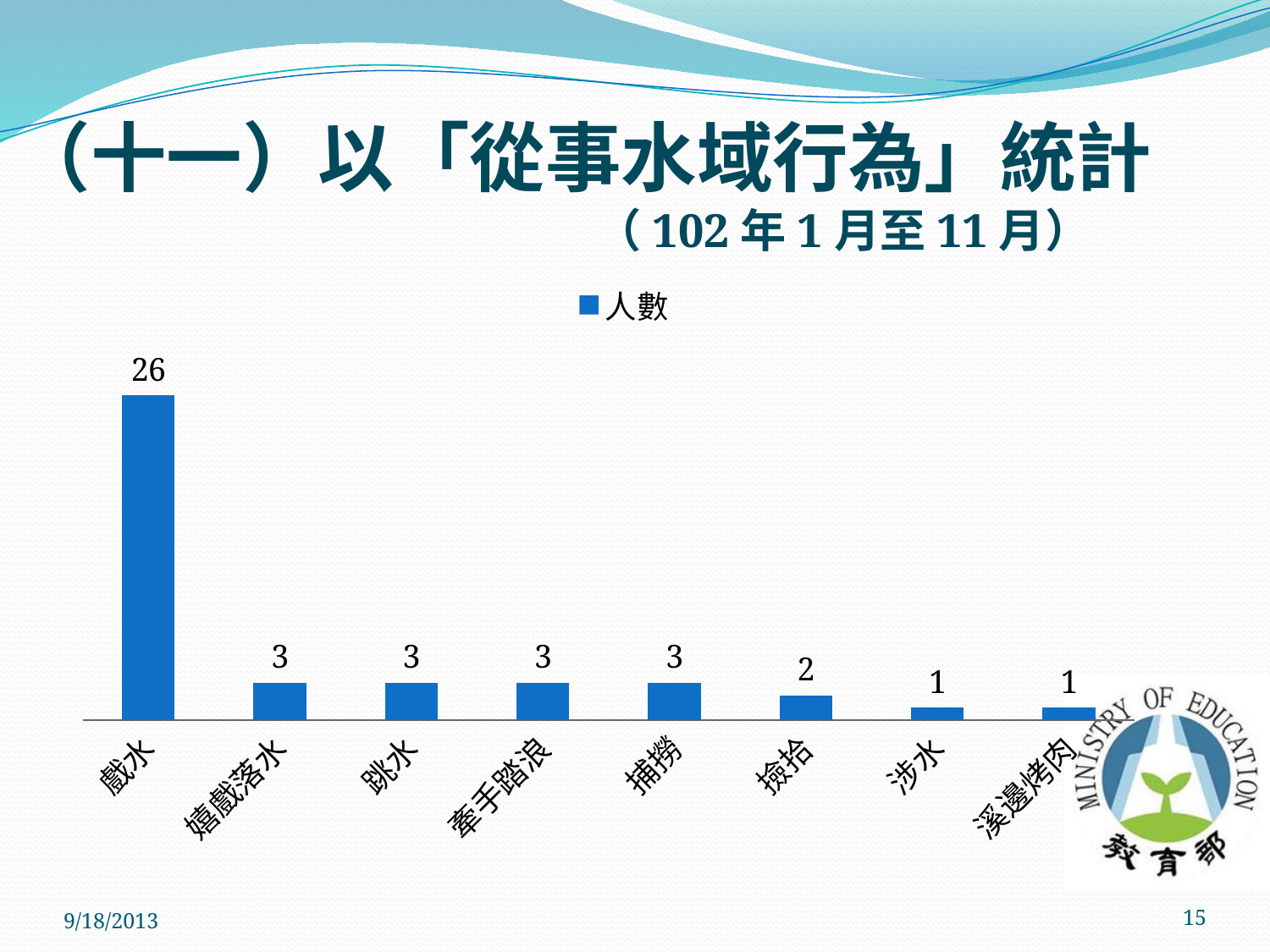
How many series does the legend list? 1 How many categories are shown on the x axis? 8 What is the difference between the values for 跳水 and 撿拾? 1 What is the value for 捕撈? 3 Which category has the highest value? 戲水 What is the value for 涉水? 1 What kind of chart is shown on the slide? bar chart What is the name of the series shown in the legend? 人數 What is the value for 戲水? 26 What is the difference between the values for 戲水 and 嬉戲落水? 23 Which is larger, the value for 牽手踏浪 or the value for 溪邊烤肉? 牽手踏浪 What is the value for 撿拾? 2